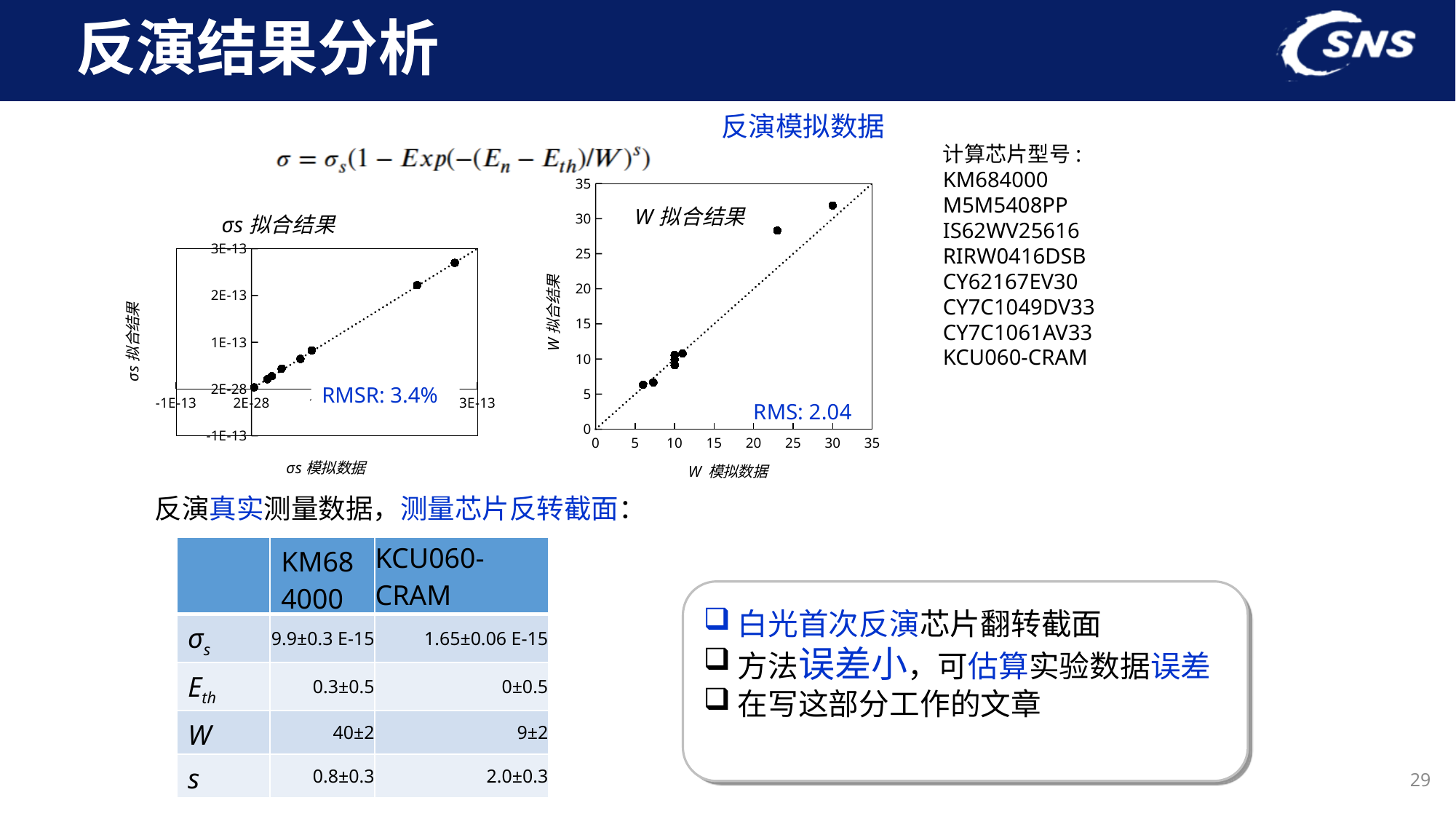
In the "σs 拟合结果" chart, is the fitted value of the highest point greater or less than 2E-13? greater In the "σs 拟合结果" chart, do the fitted σs values rise or fall as the simulated σs values increase along the x axis? rise What kind of chart is the "W 拟合结果" chart on the right? scatter chart What kind of chart is the "σs 拟合结果" chart on the left? scatter chart In the "W 拟合结果" chart, are the fitted values of the two lowest points greater or less than 10? less In the "W 拟合结果" chart, is the fitted value of the point at a simulated W of about 23 greater or less than 30? less What RMS value is printed on the "W 拟合结果" chart? 2.04 In the "W 拟合结果" chart, do the fitted values rise or fall as the simulated W values increase along the x axis? rise What RMSR value is printed on the "σs 拟合结果" chart? 3.4%